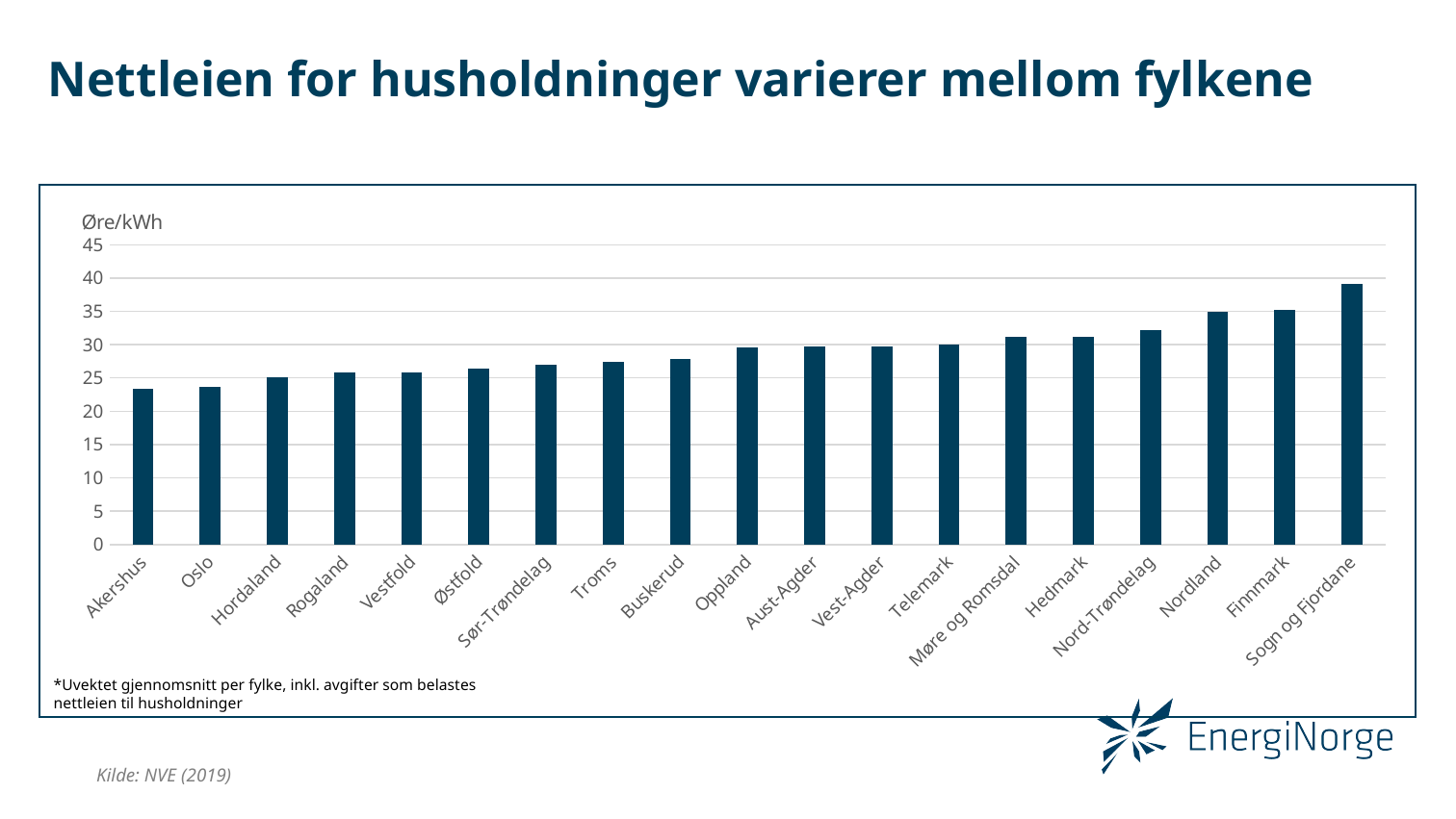
Is the value for Sogn og Fjordane greater or less than 35? greater Which fylke has the highest nettleie in the chart? Sogn og Fjordane How many fylker (categories) are shown on the x axis of the chart? 19 Is the value for Troms greater or less than 30? less Is the value for Akershus greater or less than 25? less Which is larger, the value for Nordland or the value for Oslo? Nordland Which is larger, the value for Hordaland or the value for Nord-Trøndelag? Nord-Trøndelag What unit is shown on the y axis of the chart? Øre/kWh What kind of chart is shown on the slide? bar chart Do the values rise or fall from left to right along the x axis? rise